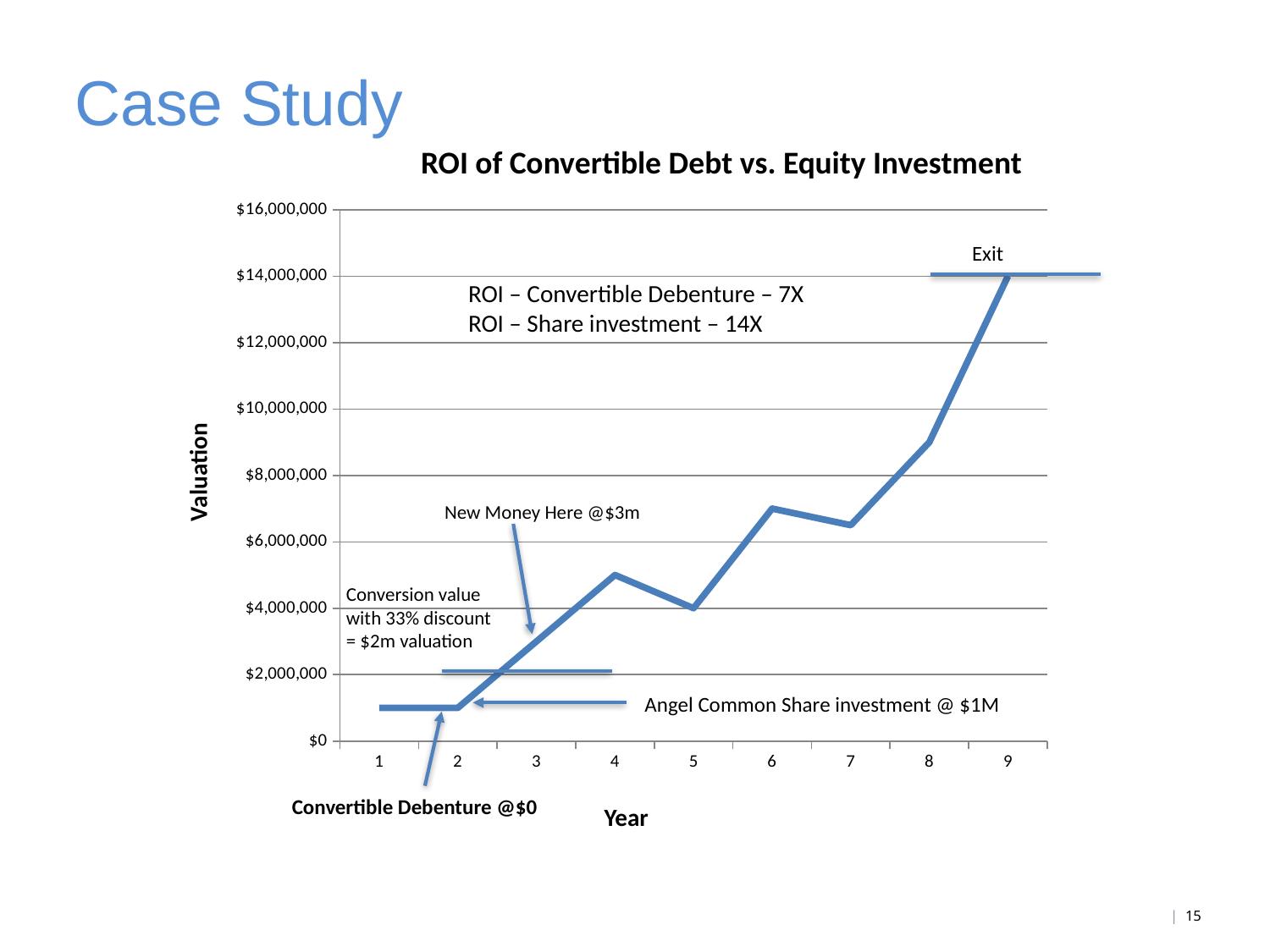
Is the valuation in year 8 greater or less than $8,000,000? greater What kind of chart is shown on the slide? line chart What is the valuation in year 9? $14,000,000 Is the valuation in year 1 greater or less than $2,000,000? less Does the valuation generally rise or fall from year 1 to year 9? rise What is the label of the vertical axis? Valuation What is the title of the chart? ROI of Convertible Debt vs. Equity Investment Is the valuation in year 6 greater or less than $6,000,000? greater How many years are plotted along the x axis? 9 Which year has the larger valuation, year 4 or year 5? year 4 What is the valuation in year 5? $4,000,000 Which year has the highest valuation? 9